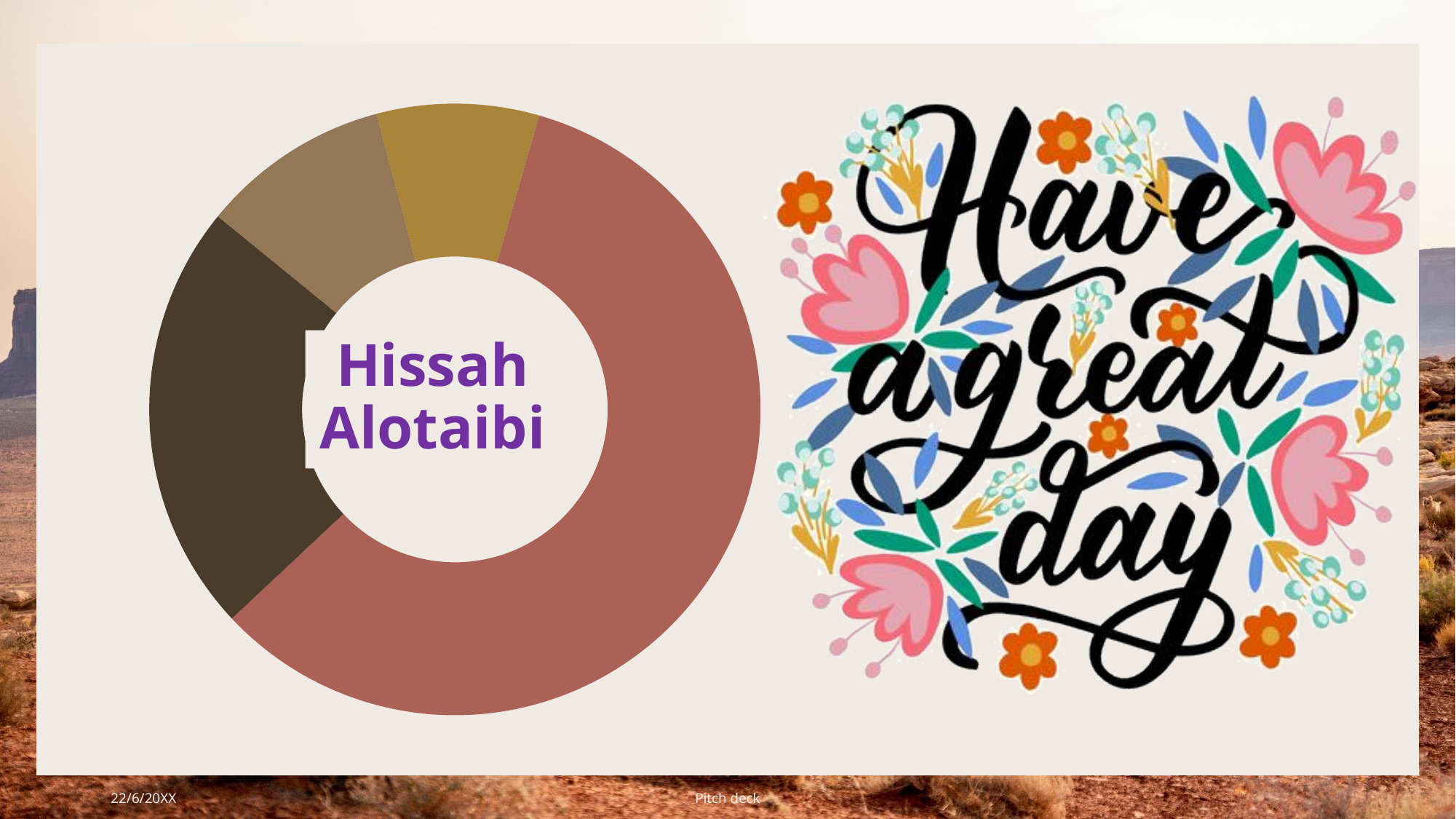
What kind of chart is shown on the left of the slide? Doughnut (pie) chart What text appears in the centre of the doughnut chart? Hissah Alotaibi Which slice is larger in the doughnut chart, the reddish-brown slice or the dark brown slice? The reddish-brown slice Which colour slice is the largest in the doughnut chart? The reddish-brown slice How many slices does the doughnut chart have? 4 Does the doughnut chart display a legend? No Which slice is larger in the doughnut chart, the dark brown slice or the gold slice? The dark brown slice